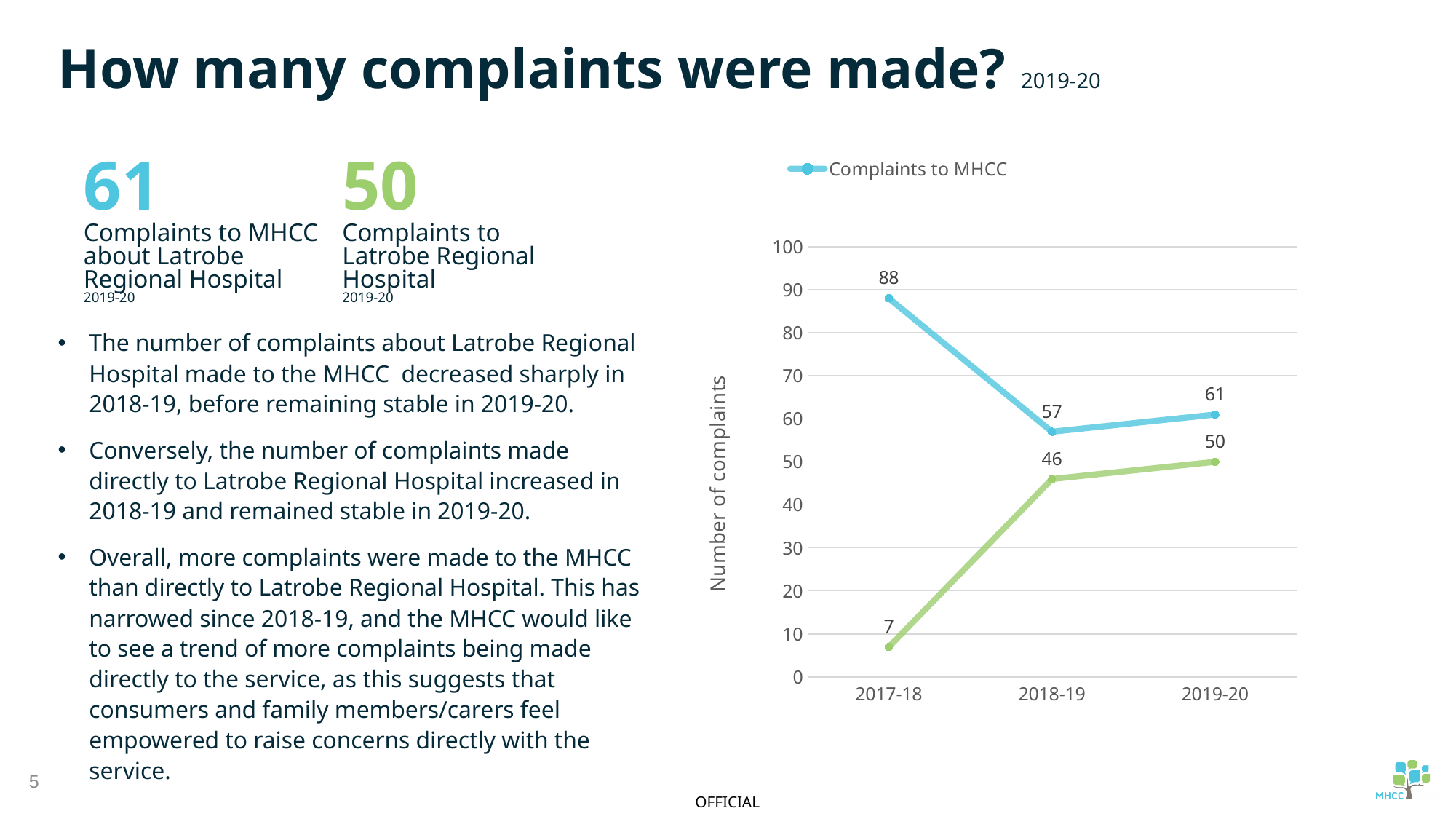
How many years are shown on the x axis of the chart? 3 What is the value of the Complaints to MHCC line in 2017-18? 88 In which year is the Complaints to MHCC line at its highest? 2017-18 What is the value of the green line in 2019-20? 50 What is the value of the Complaints to MHCC line in 2018-19? 57 In which year is the green line at its lowest? 2017-18 Does the green line rise or fall from 2017-18 to 2019-20? rise What is the value of the green line in 2017-18? 7 Which is larger in 2018-19: the Complaints to MHCC value or the green line value? Complaints to MHCC What type of chart is shown on the slide? line chart What is the difference between the Complaints to MHCC value and the green line value in 2019-20? 11 What is the value of the Complaints to MHCC line in 2019-20? 61